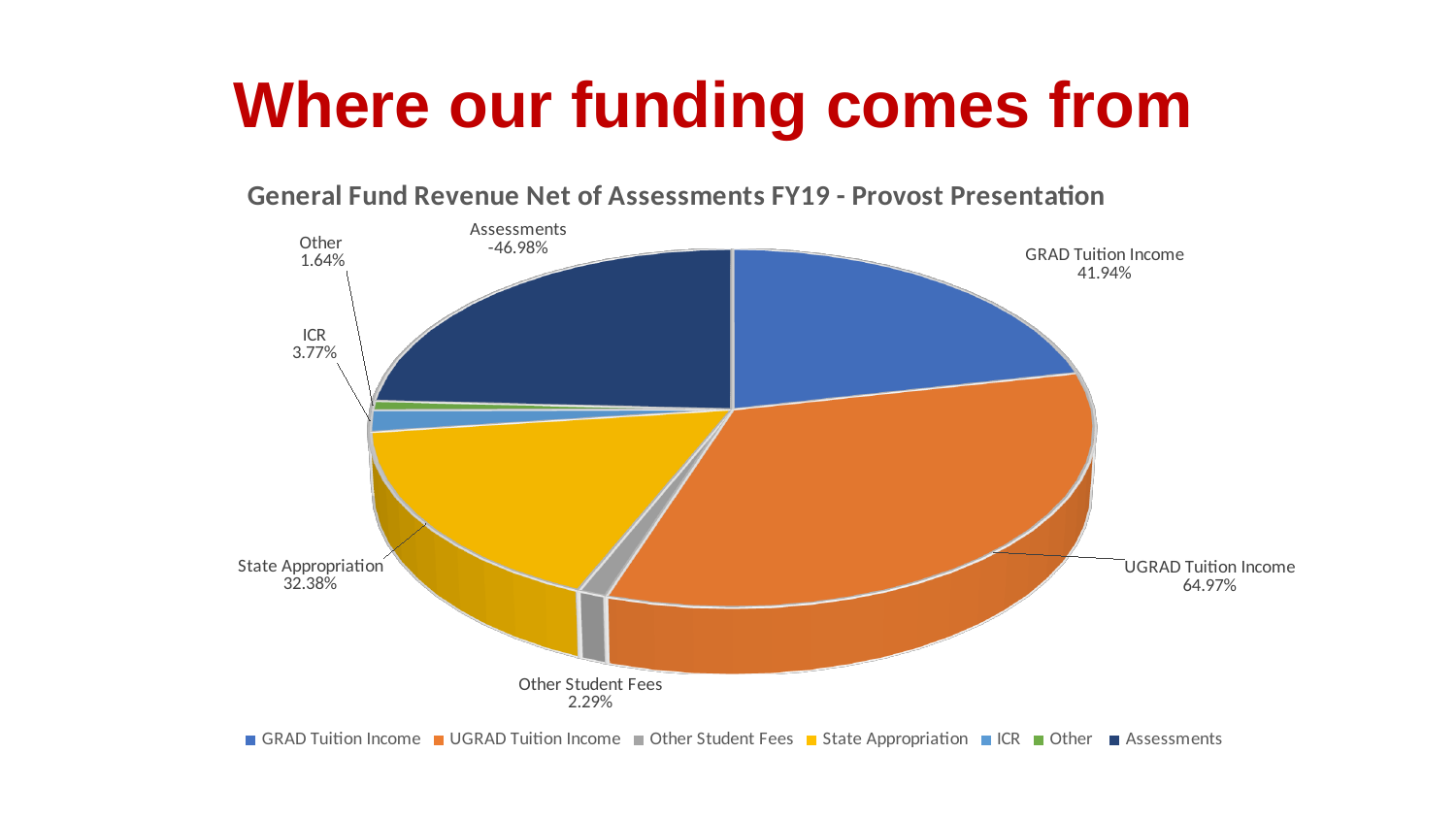
What is the title of the chart? General Fund Revenue Net of Assessments FY19 - Provost Presentation What percentage is labelled for State Appropriation? 32.38% What percentage is labelled for GRAD Tuition Income? 41.94% What percentage is labelled for UGRAD Tuition Income? 64.97% What percentage is labelled for Assessments? -46.98% What is the difference between the labelled percentages for UGRAD Tuition Income and GRAD Tuition Income? 23.03% Which is larger, the percentage for Other Student Fees or the percentage for Other? Other Student Fees Which category has the lowest labelled percentage? Assessments How many categories does the legend list? 7 What type of chart is shown on the slide? Pie chart Which category has the largest labelled percentage? UGRAD Tuition Income What percentage is labelled for ICR? 3.77%